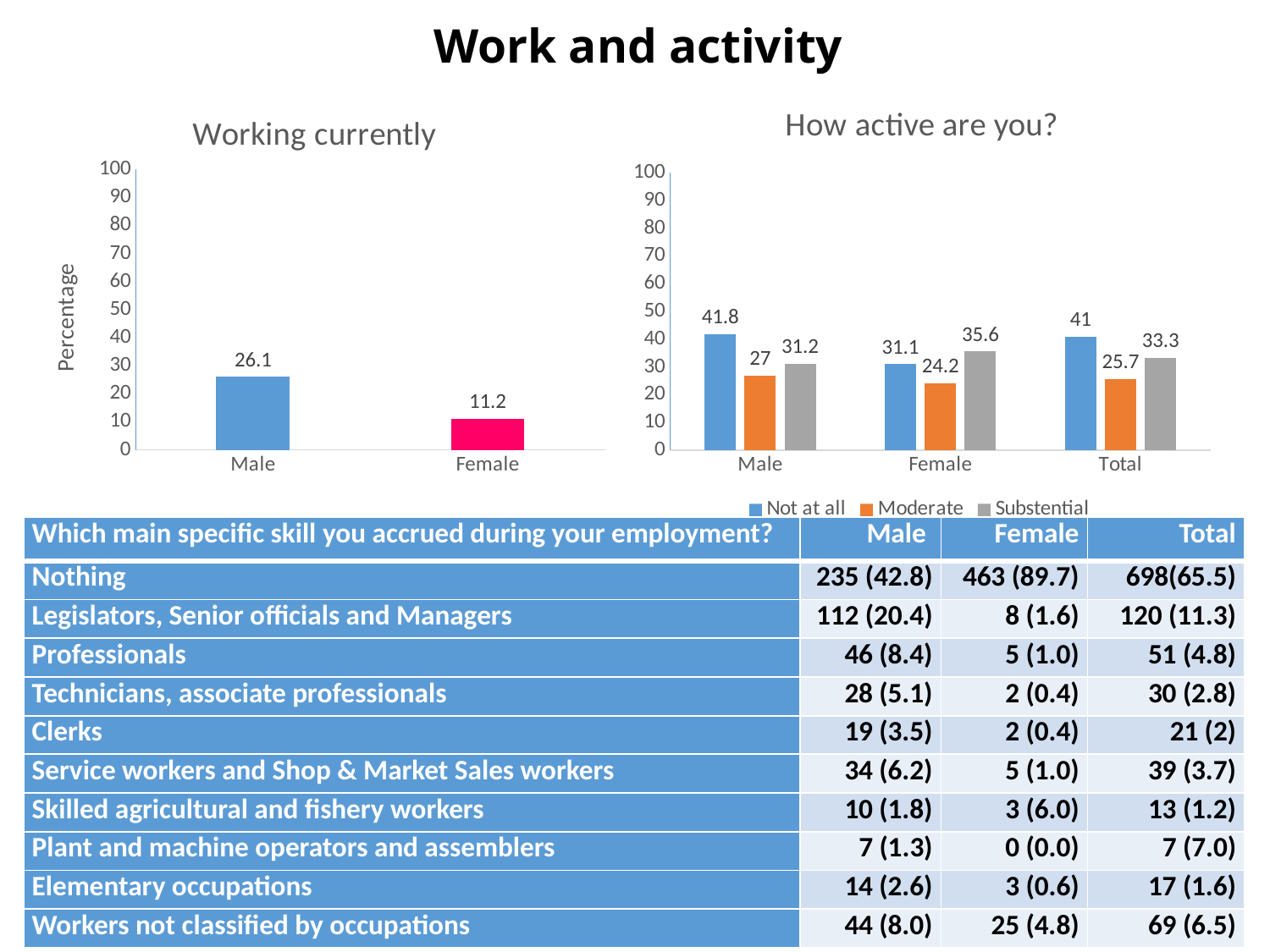
In the 'How active are you?' chart, which series has the highest value for Male? Not at all In the 'Working currently' chart, what is the difference between the Male and Female values? 14.9 In the 'How active are you?' chart, what is the difference between the 'Not at all' values for Male and Female? 10.7 In the 'How active are you?' chart, how many series does the legend list? 3 In the 'Working currently' chart, what is the y-axis label? Percentage In the 'Working currently' chart, what is the value for Male? 26.1 In the 'Working currently' chart, which category has the higher value, Male or Female? Male In the 'How active are you?' chart, what is the 'Not at all' value for Male? 41.8 In the 'Working currently' chart, what is the value for Female? 11.2 In the 'How active are you?' chart, what is the 'Moderate' value for Total? 25.7 What kind of chart is 'How active are you?'? Bar chart In the 'How active are you?' chart, what is the 'Substantial' value for Female? 35.6